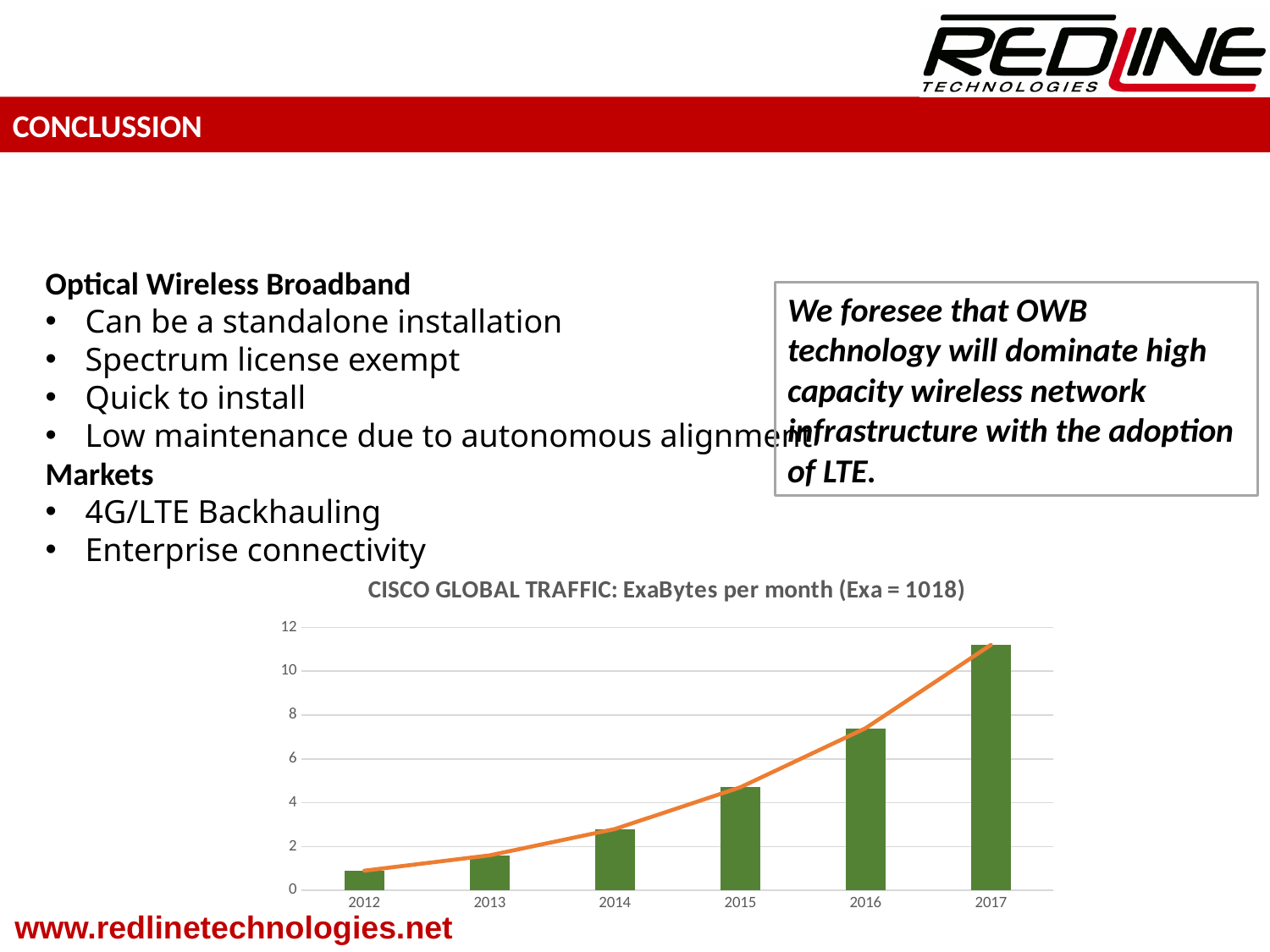
Which year has the highest value in the chart? 2017 Is the value for 2013 greater or less than 2? less What is the title of the chart? CISCO GLOBAL TRAFFIC: ExaBytes per month (Exa = 1018) Which is larger, the value for 2014 or the value for 2016? 2016 How many years are shown on the x axis of the chart? 6 What colour are the bars in the chart? green Do the values rise or fall from 2012 to 2017? rise What kind of chart is shown on the slide? combination bar and line chart Is the value for 2016 greater or less than 8? less Is the value for 2017 greater or less than 10? greater Which year has the lowest value in the chart? 2012